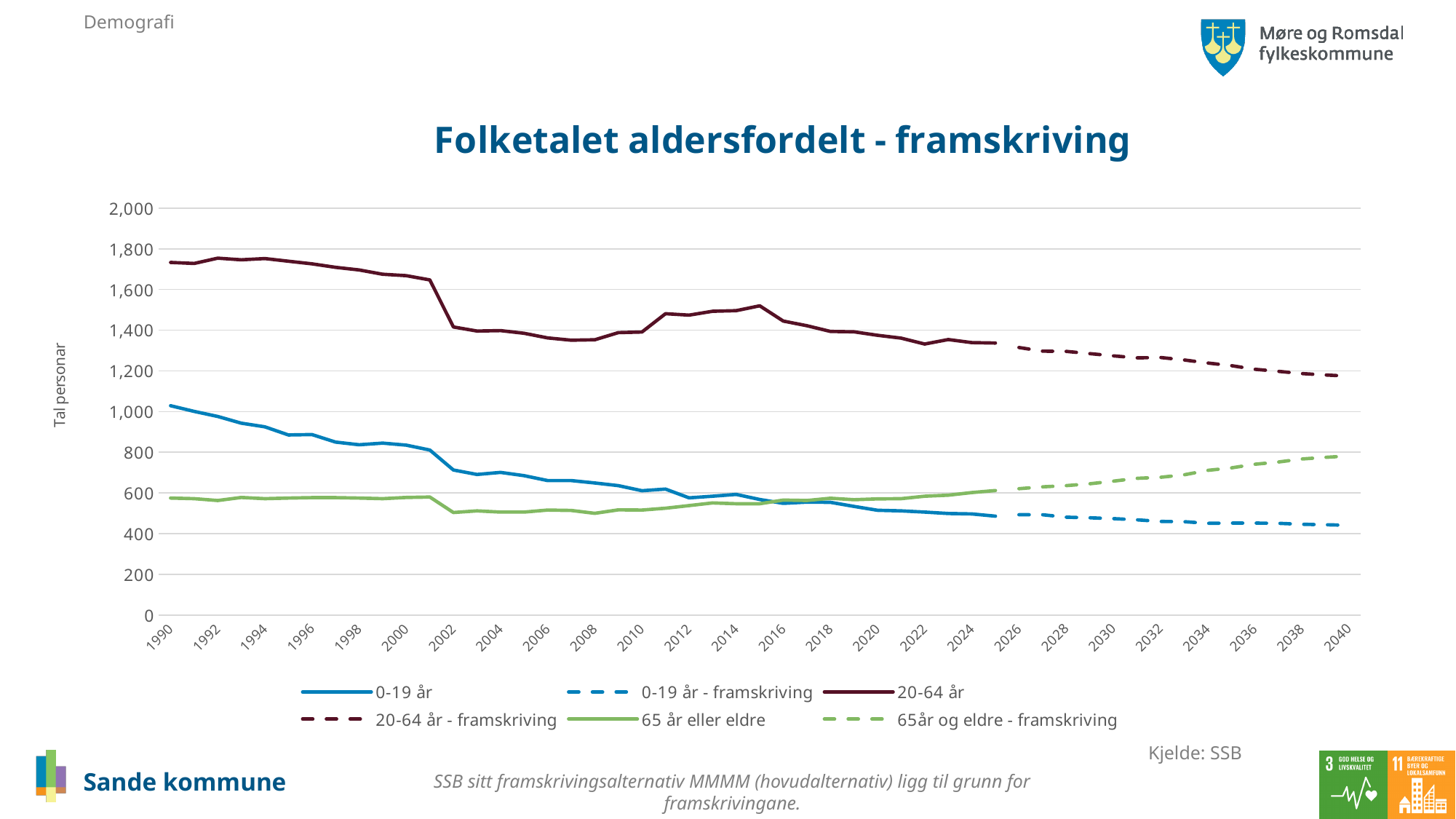
In 1990, which series has the higher value: 0-19 år or 65 år eller eldre? 0-19 år What is the label on the y axis? Tal personar Is the value for 0-19 år - framskriving in 2040 greater or less than 600? less Is the value for 20-64 år - framskriving in 2040 greater or less than 1,400? less Is the value for 20-64 år in 1990 greater or less than 1,600? greater What is the title of the chart? Folketalet aldersfordelt - framskriving How many series does the legend list? 6 Does the 20-64 år series rise or fall overall from 1990 to 2024? fall Does the 65år og eldre - framskriving series rise or fall from 2026 to 2040? rise Does the 0-19 år series rise or fall overall from 1990 to 2024? fall In 2040, which series has the higher value: 0-19 år - framskriving or 65år og eldre - framskriving? 65år og eldre - framskriving What kind of chart is shown on the slide? line chart